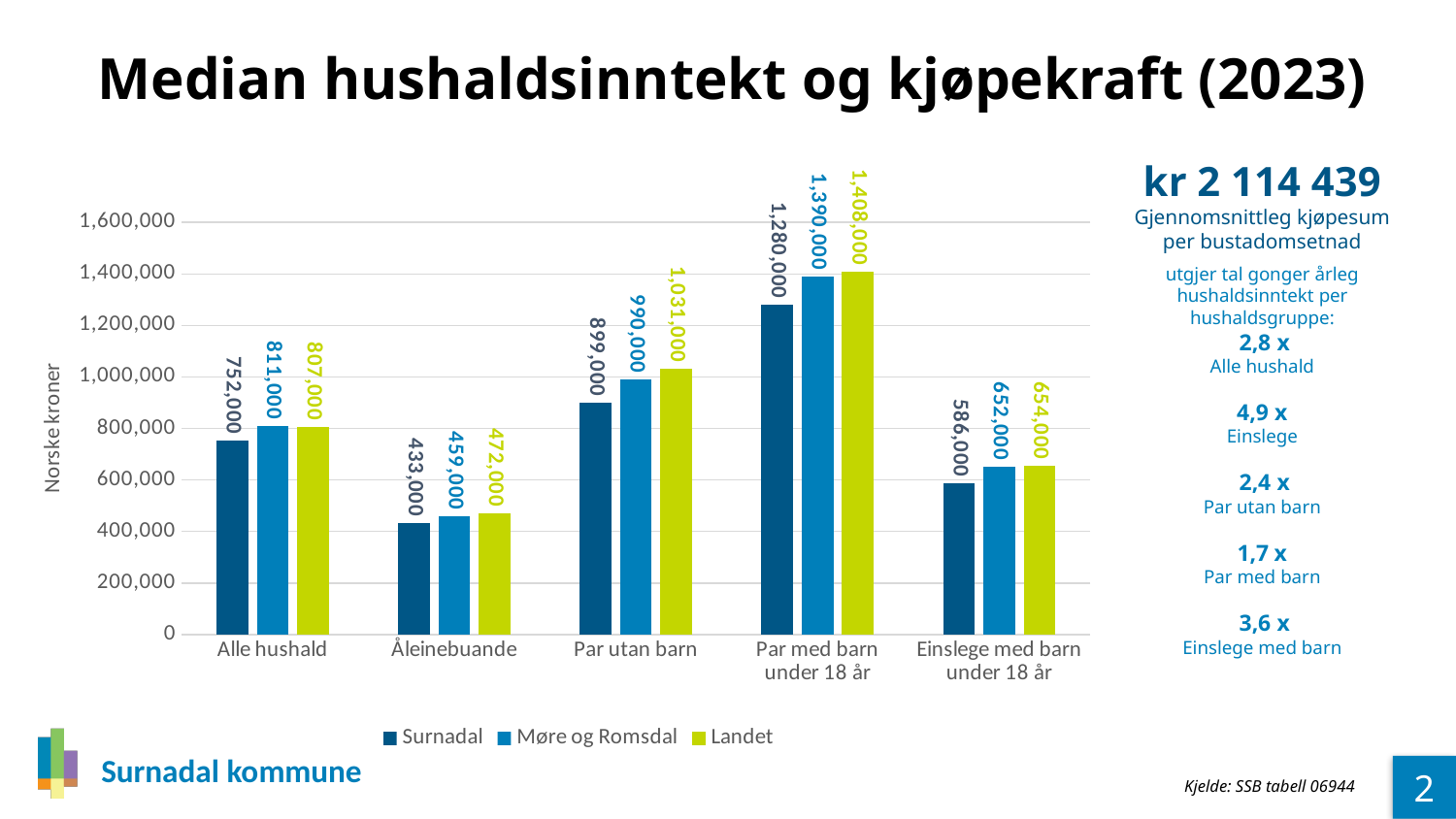
How many series does the legend list? 3 What is the value for Surnadal in the Alle hushald category? 752,000 Which category has the highest value for Surnadal? Par med barn under 18 år What is the difference between the Landet and Surnadal values in the Par med barn under 18 år category? 128,000 Is the value for Surnadal in the Par utan barn category greater or less than 1,000,000? less What kind of chart is shown on the slide? bar chart Which category has the lowest value for Landet? Åleinebuande In the Alle hushald category, which is larger: Møre og Romsdal or Landet? Møre og Romsdal What is the value for Møre og Romsdal in the Åleinebuande category? 459,000 How many household categories are shown on the x axis? 5 What is the value for Landet in the Par utan barn category? 1,031,000 What is the label on the vertical axis of the chart? Norske kroner